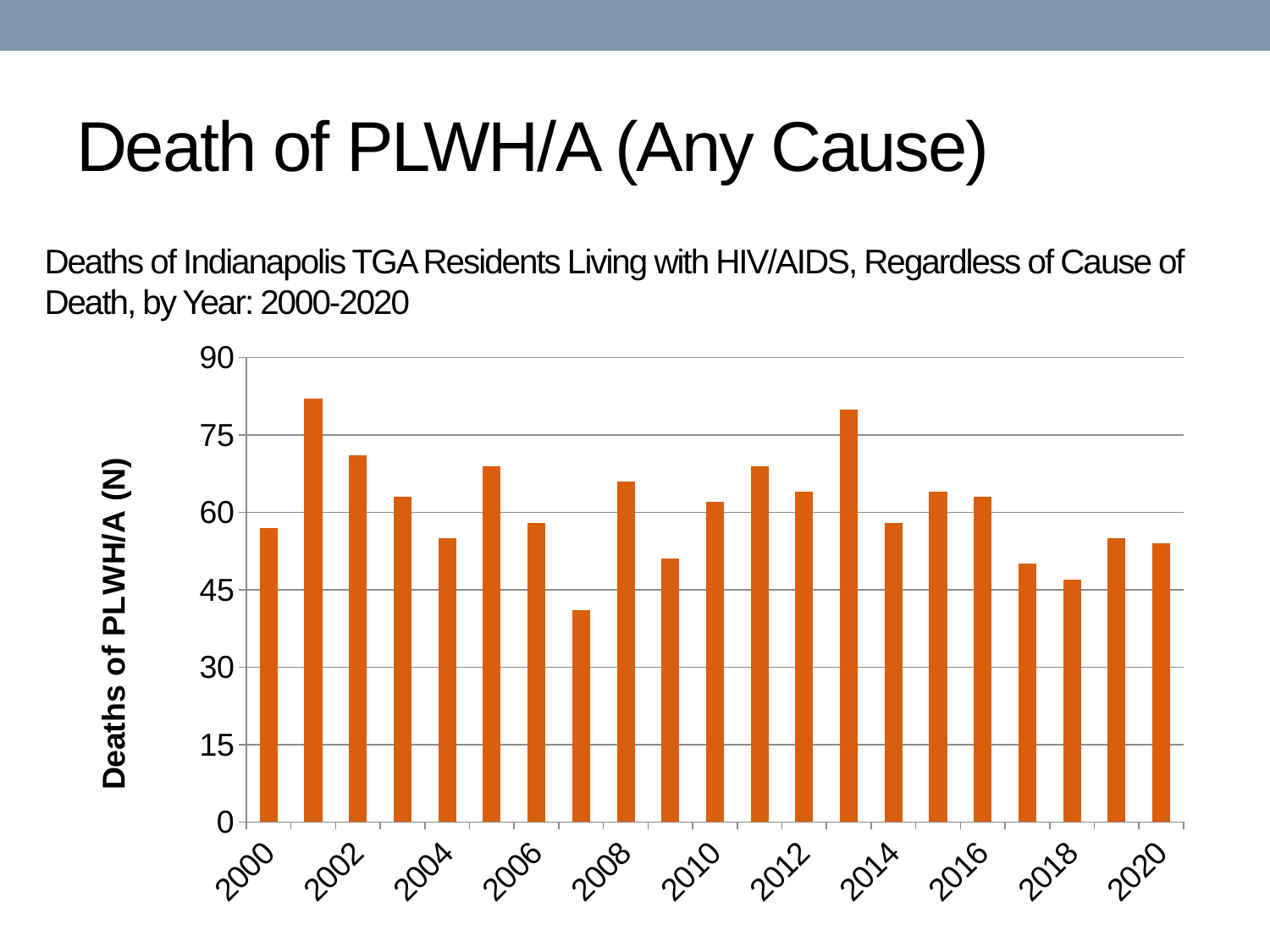
What kind of chart is shown on the slide? bar chart Is the value for 2000 greater or less than 60? less Which year has more deaths, 2002 or 2004? 2002 Do the values rise or fall from 2016 to 2018? fall Which year has the lowest number of deaths? 2007 Is the value for 2002 greater or less than 75? less What is the title of the vertical axis? Deaths of PLWH/A (N) Is the value for 2012 greater or less than 60? greater How many bars (years) are plotted in the chart? 21 Which year has more deaths, 2016 or 2018? 2016